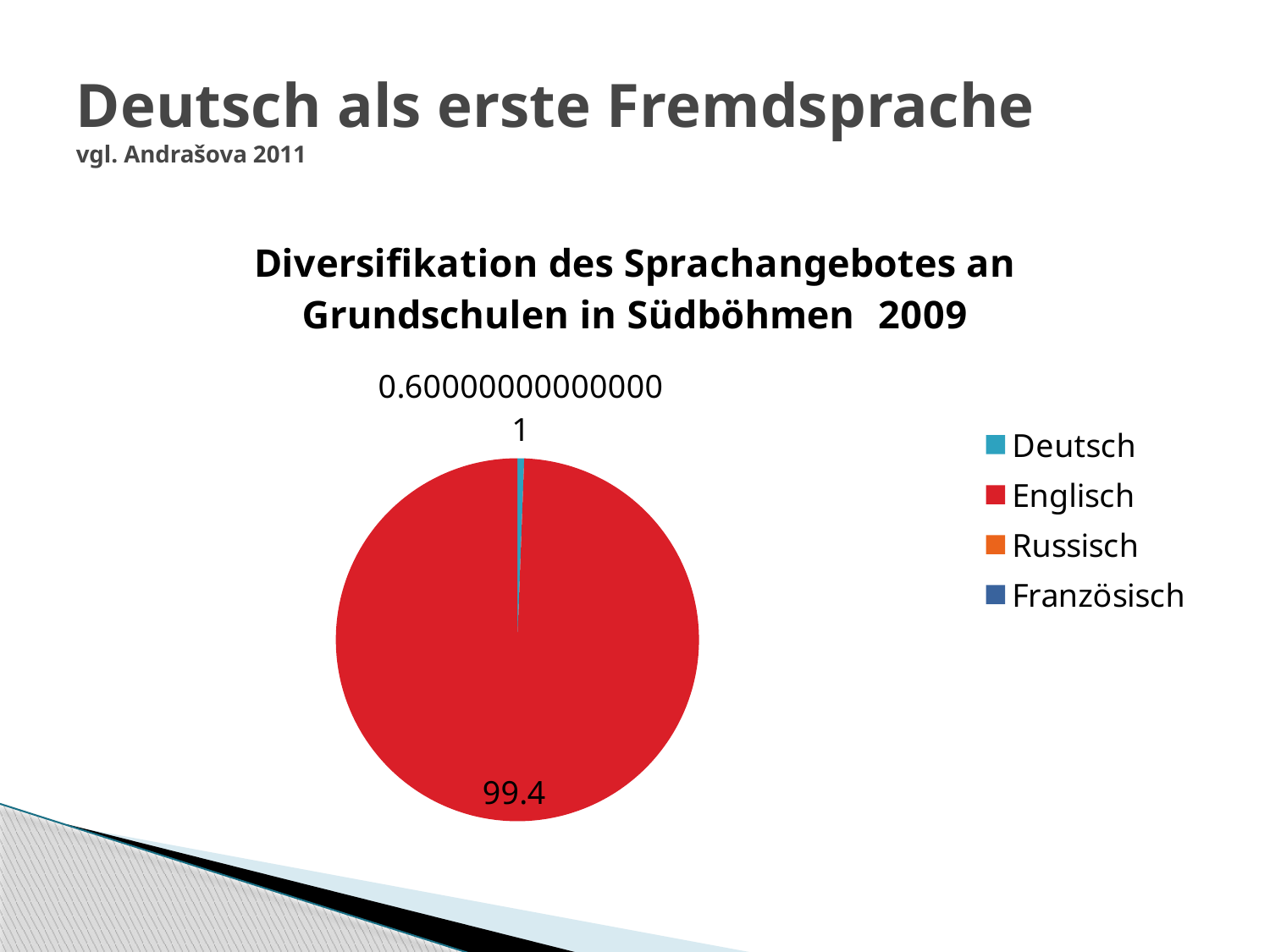
What value is shown for Deutsch in the pie chart? 0.600000000000001 Which is larger, the slice for Englisch or the slice for Deutsch? Englisch What kind of chart is shown on the slide? pie chart What value is shown for Englisch in the pie chart? 99.4 What colour is the slice for Englisch in the pie chart? red How many entries does the chart legend list? 4 What is the title of the chart? Diversifikation des Sprachangebotes an Grundschulen in Südböhmen 2009 Which language is listed first in the chart legend? Deutsch Which language has the largest slice of the pie chart? Englisch